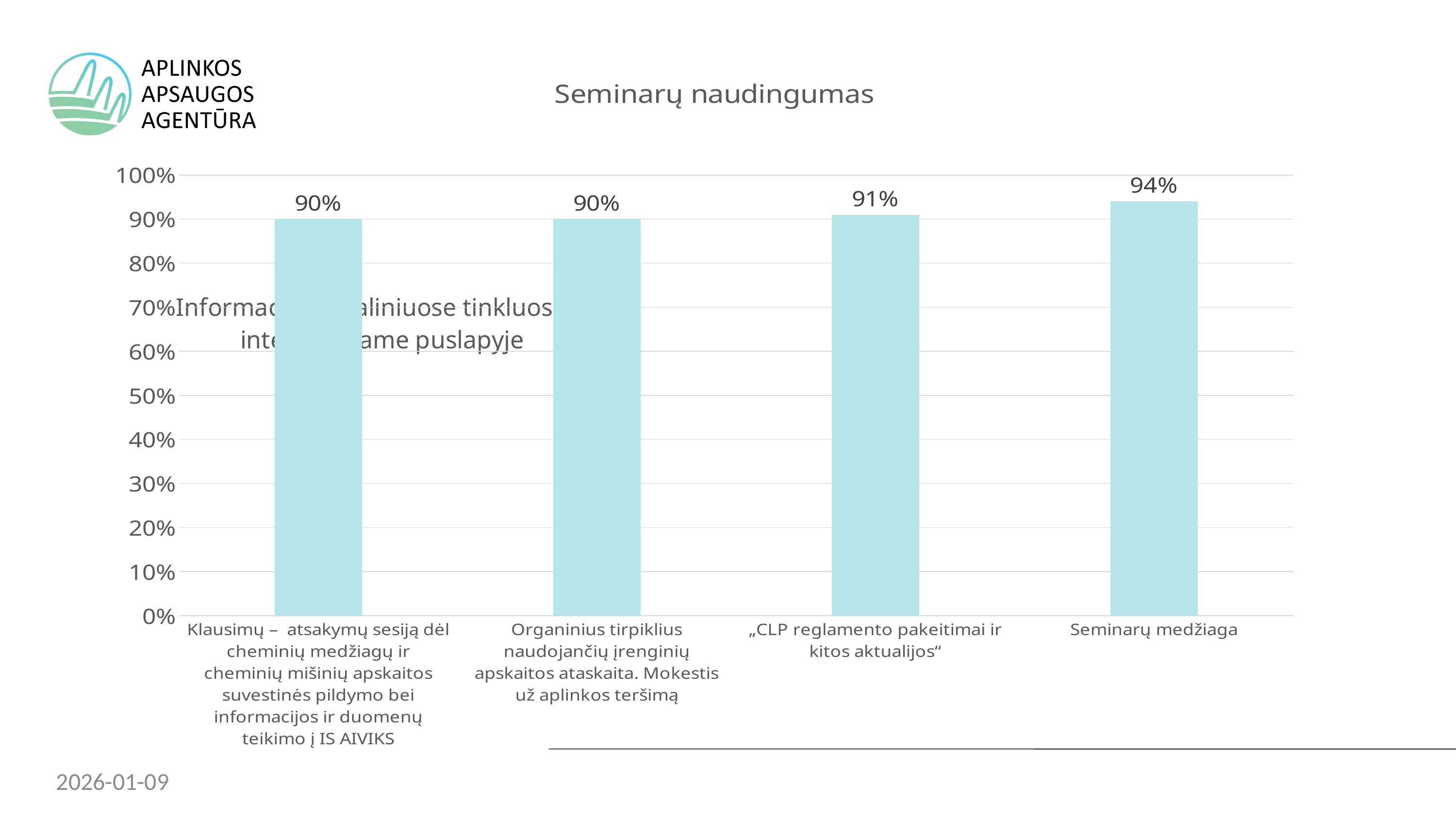
What kind of chart is shown on the slide? bar chart What is the highest value shown on the vertical axis? 100% How many categories are shown in the chart? 4 What is the title of the chart? Seminarų naudingumas What is the value for "Seminarų medžiaga"? 94% What is the value for "Organinius tirpiklius naudojančių įrenginių apskaitos ataskaita. Mokestis už aplinkos teršimą"? 90% What is the difference between the values for "Seminarų medžiaga" and "„CLP reglamento pakeitimai ir kitos aktualijos“"? 3% Which is larger: the value for "Seminarų medžiaga" or the value for "„CLP reglamento pakeitimai ir kitos aktualijos“"? Seminarų medžiaga Which category has the highest value? Seminarų medžiaga What is the value for "„CLP reglamento pakeitimai ir kitos aktualijos“"? 91% Is the value for "Seminarų medžiaga" greater or less than 80%? greater